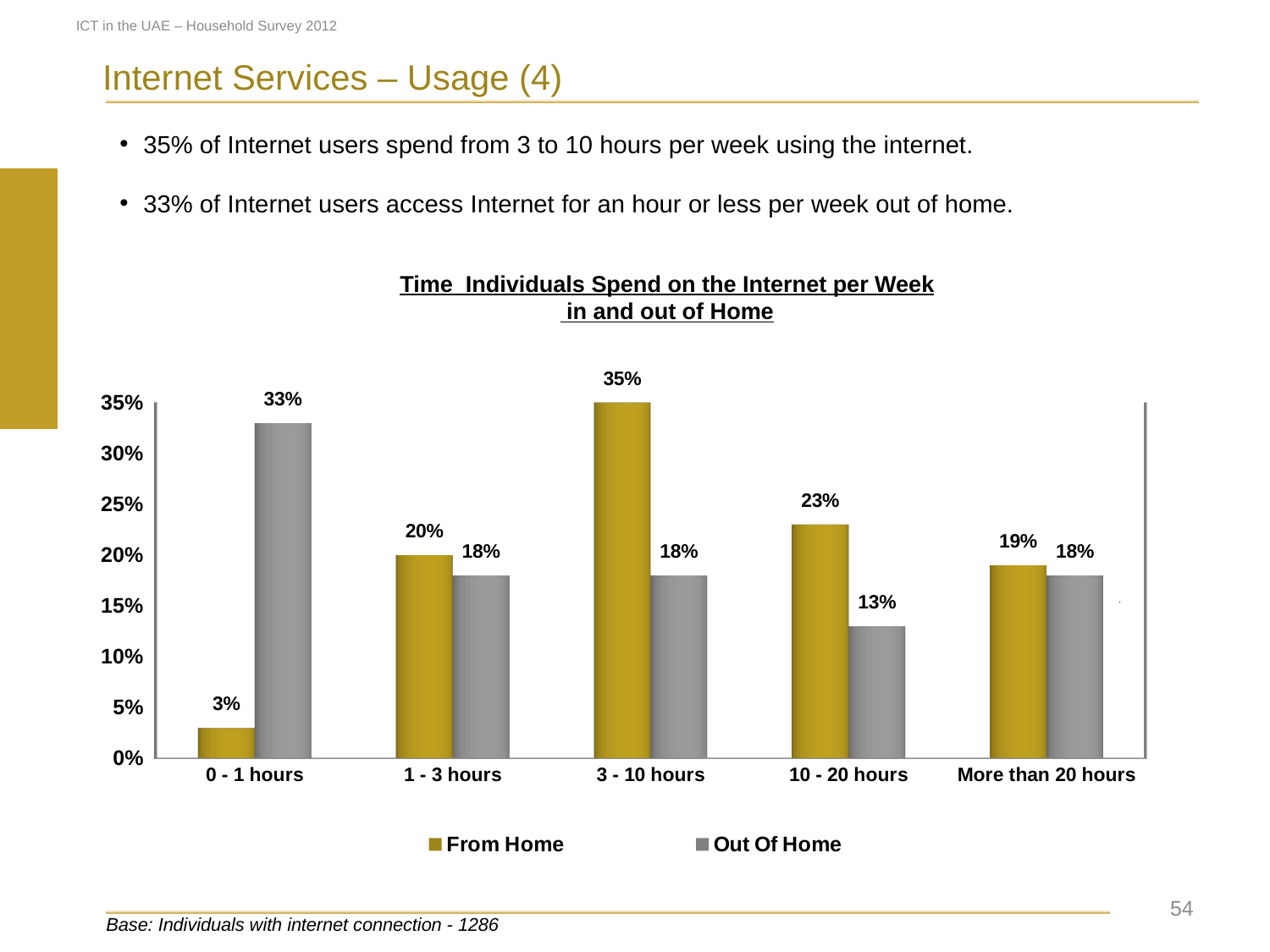
Which category has the highest From Home value? 3 - 10 hours How many categories are shown on the x axis? 5 For 10 - 20 hours, which is larger: From Home or Out Of Home? From Home What kind of chart is shown on the slide? Bar chart What is the Out Of Home value for 10 - 20 hours? 13% What is the From Home value for 3 - 10 hours? 35% What is the difference between the From Home and Out Of Home values for 3 - 10 hours? 17% What is the difference between the Out Of Home and From Home values for 0 - 1 hours? 30% Which category has the lowest From Home value? 0 - 1 hours How many series does the legend list? 2 Which category has the lowest Out Of Home value? 10 - 20 hours What is the Out Of Home value for 0 - 1 hours? 33%